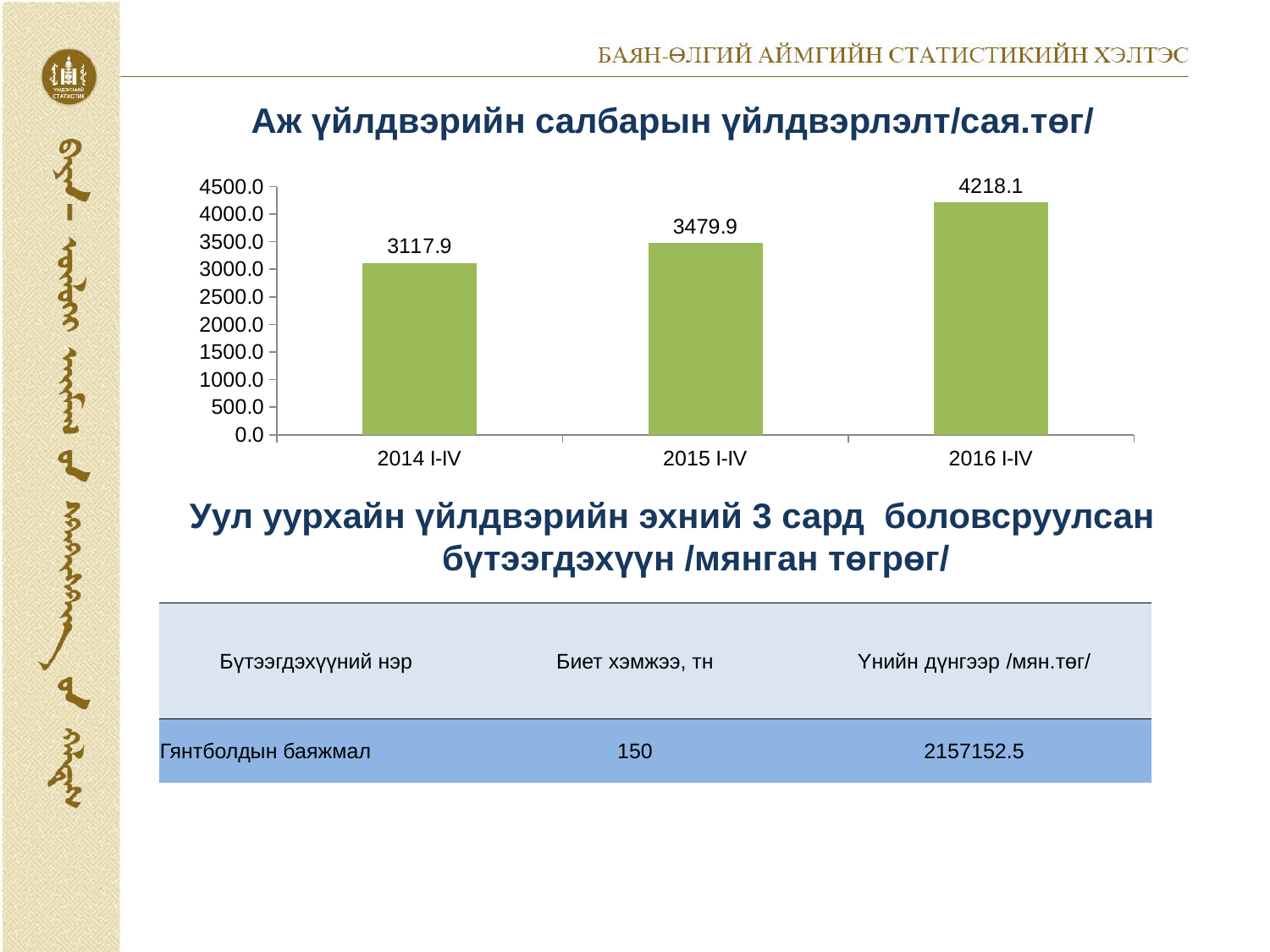
Which is larger, the value for 2015 I-IV or the value for 2016 I-IV? 2016 I-IV What is the value for 2015 I-IV? 3479.9 What is the difference between the values for 2016 I-IV and 2014 I-IV? 1100.2 How many periods are shown on the x axis? 3 Do the values rise or fall from 2014 I-IV to 2016 I-IV? rise What kind of chart is shown on the slide? bar chart What is the value for 2016 I-IV? 4218.1 Which period has the lowest value? 2014 I-IV Is the value for 2016 I-IV greater or less than 4000.0? greater Which period has the highest value? 2016 I-IV What is the difference between the values for 2015 I-IV and 2014 I-IV? 362.0 What is the value for 2014 I-IV? 3117.9